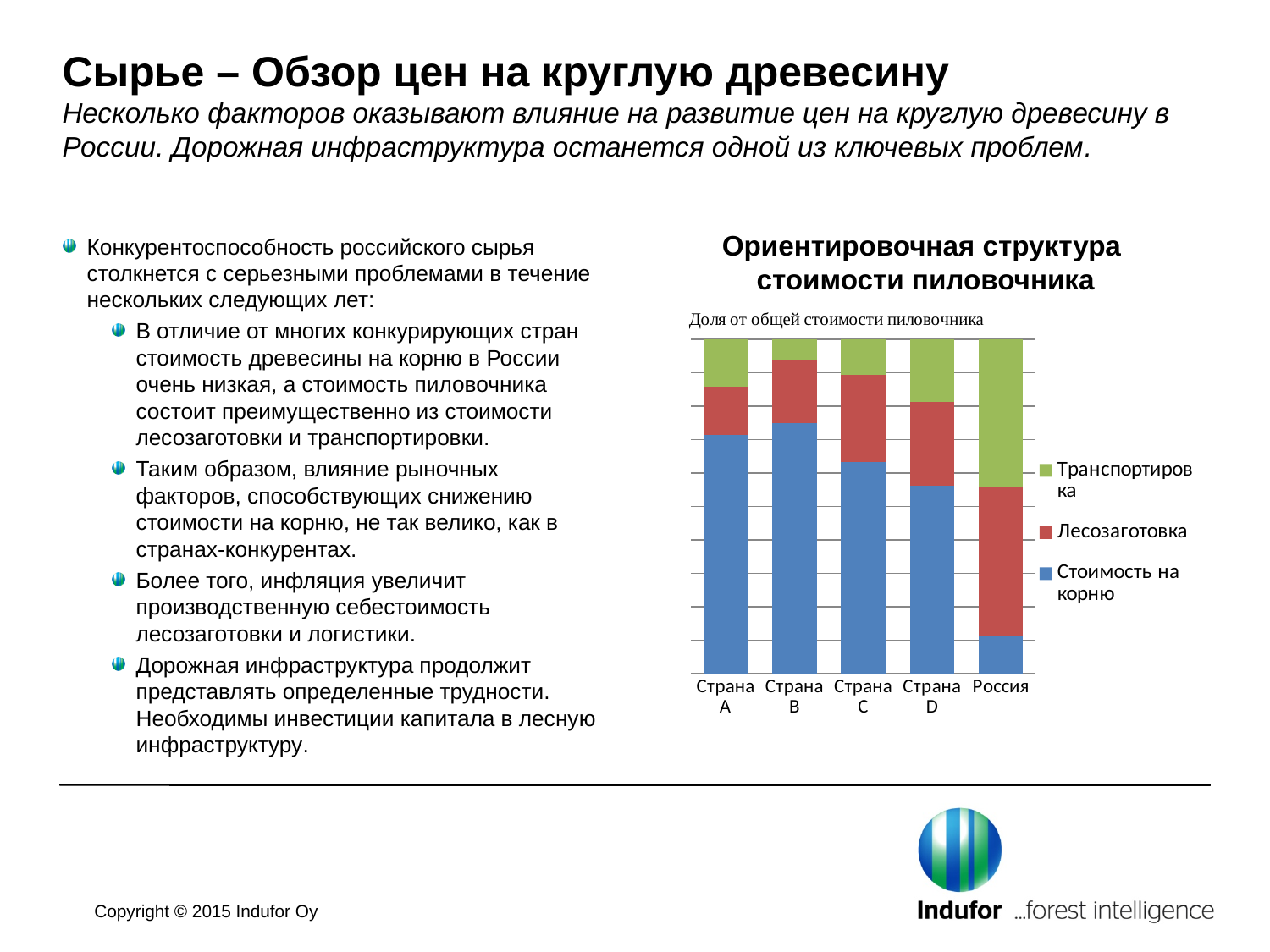
How many categories are shown along the x axis of the chart? 5 Which has the larger share for Лесозаготовка, Страна A or Россия? Россия What kind of chart is shown on the slide? Stacked bar chart Which category has the smallest share for Стоимость на корню? Россия Which has the larger share for Стоимость на корню, Страна A or Россия? Страна A Which has the larger share for Транспортировка, Страна B or Россия? Россия Which series is shown in blue in the chart? Стоимость на корню What is the title of the chart? Ориентировочная структура стоимости пиловочника Which category has the largest share for Транспортировка? Россия Which category has the smallest share for Транспортировка? Страна B How many series does the chart legend list? 3